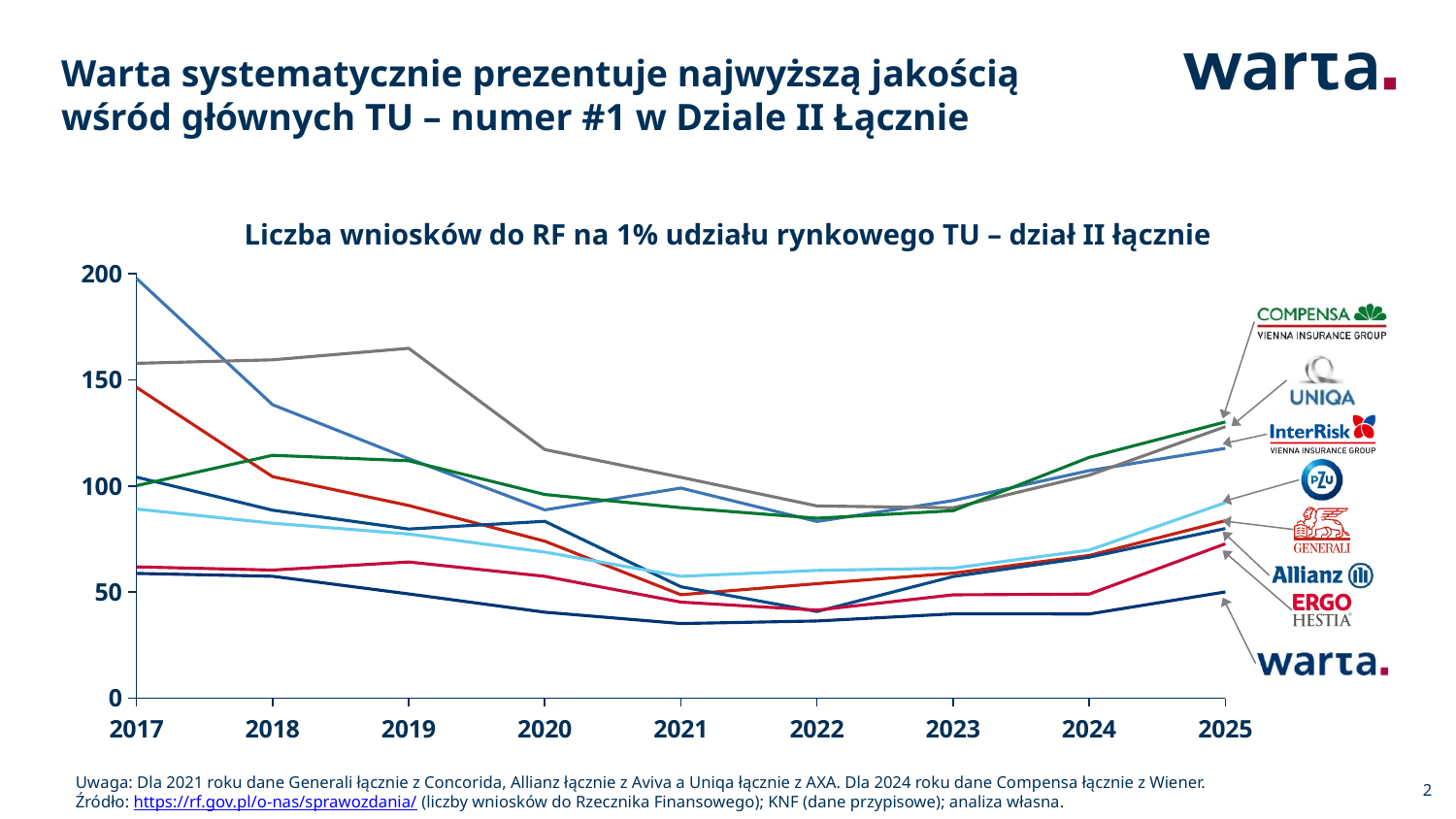
How many insurance companies (series) are plotted on the chart? 8 Which company has the lowest value in 2025? Warta Is the value for Warta in 2021 greater or less than 50? less Is the value for InterRisk in 2017 greater or less than 150? greater What kind of chart is shown on the slide? line chart Is the value for PZU in 2025 greater or less than 100? less How many years are shown along the x axis of the chart? 9 Which company has the highest value in 2017? InterRisk Does the value for InterRisk rise or fall from 2017 to 2022? fall Which is larger in 2025, the value for Compensa or the value for Warta? Compensa What is the title of the chart? Liczba wniosków do RF na 1% udziału rynkowego TU – dział II łącznie